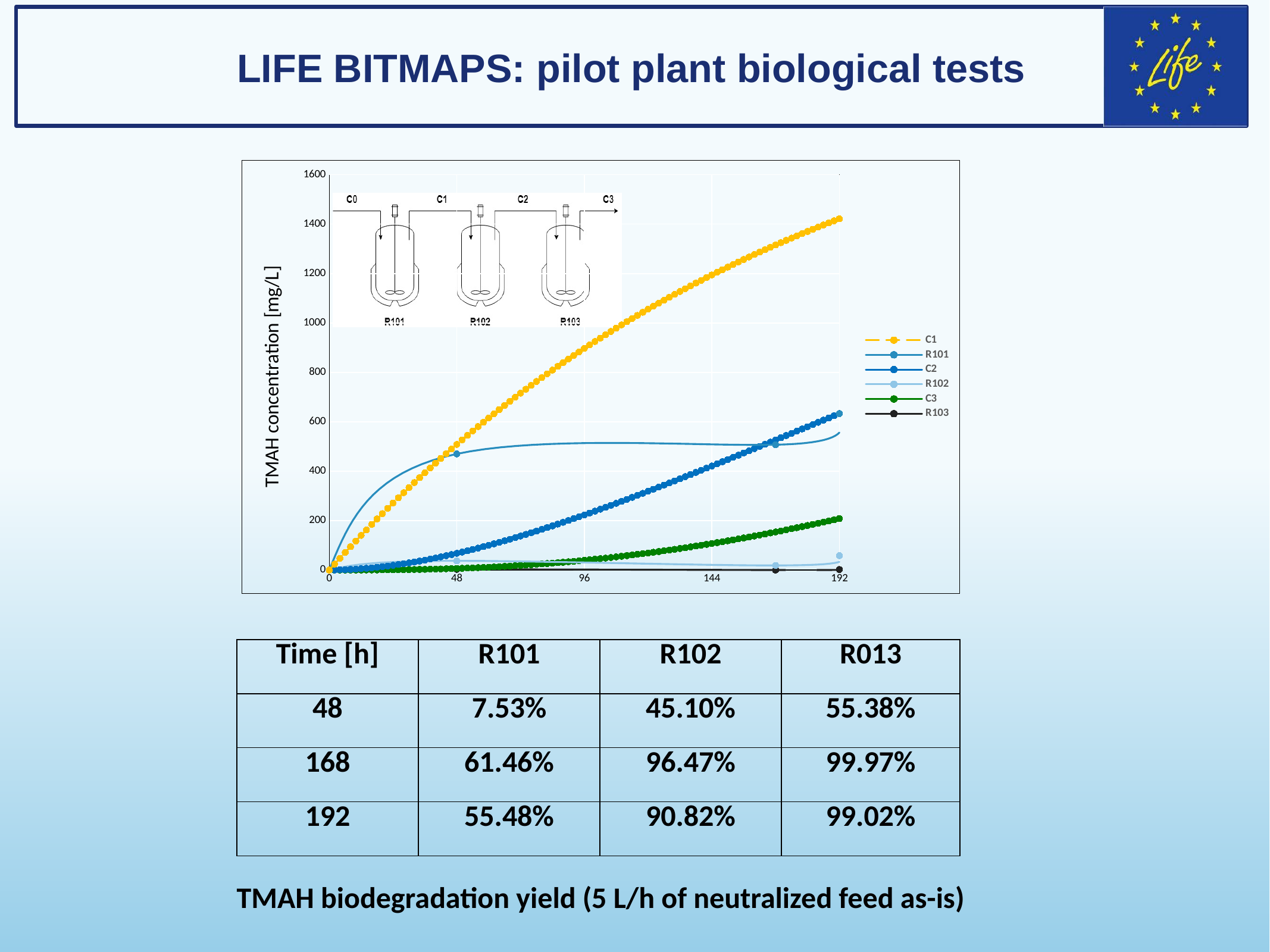
How many series does the chart legend list? 6 What is the largest value shown on the x axis of the chart? 192 Is the TMAH concentration of C3 at 192 h greater or less than 400 mg/L? less Does the C1 series rise or fall as time increases along the x axis? rises What kind of chart is shown on the slide? line chart Which series has the lowest TMAH concentration across the chart? R103 Which series reaches the highest TMAH concentration at 192 h? C1 Is the TMAH concentration of C2 at 192 h greater or less than 400 mg/L? greater Is the TMAH concentration of R103 at 192 h greater or less than 200 mg/L? less What is the label of the vertical axis of the chart? TMAH concentration [mg/L] At 192 h, which series has the larger TMAH concentration, C2 or C3? C2